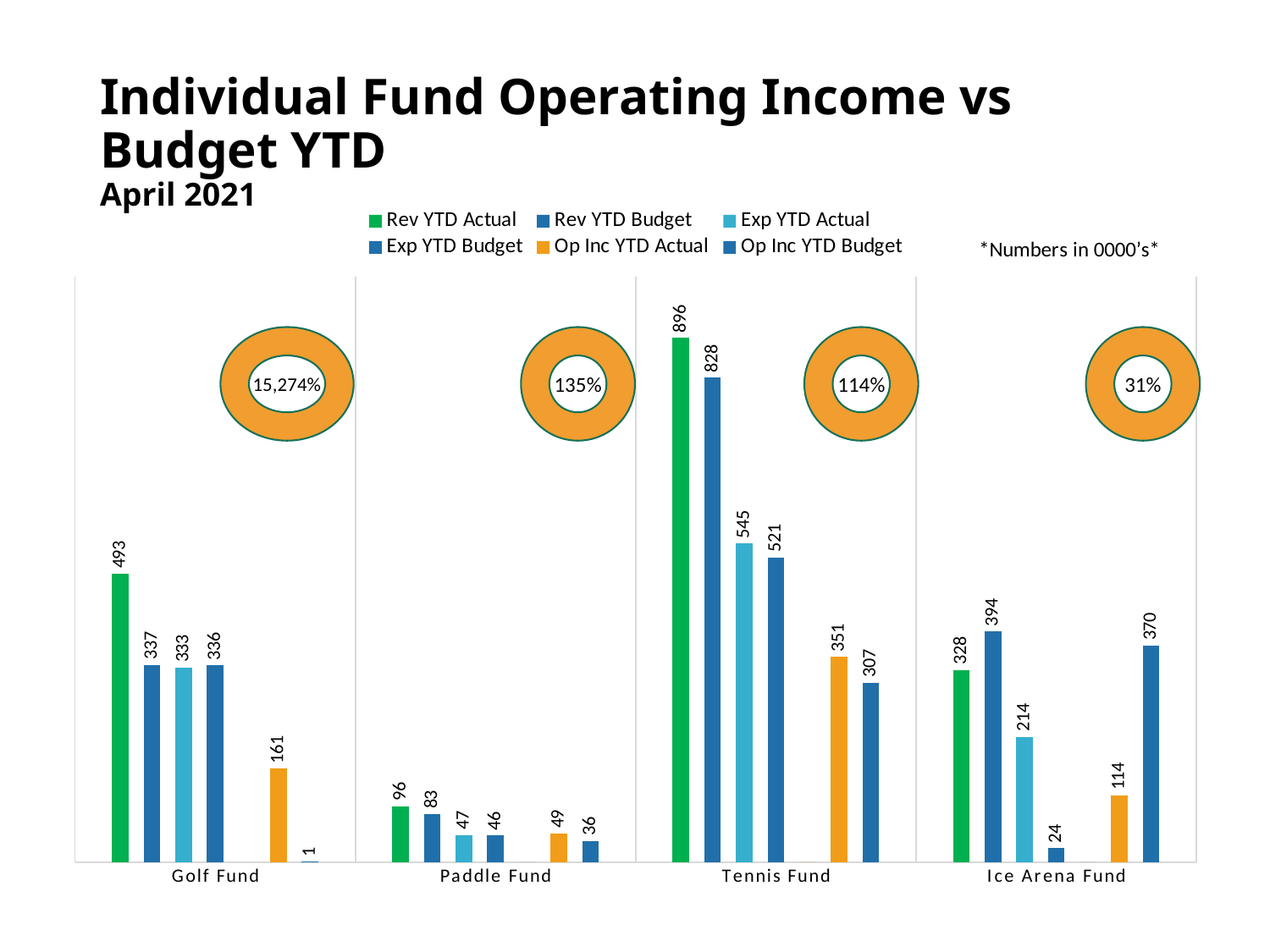
How many funds are shown on the x axis of the bar chart? 4 What kind of chart is used to show the fund values? Bar chart What percentage is shown in the donut above the Ice Arena Fund? 31% Which is larger for the Ice Arena Fund, Rev YTD Actual or Rev YTD Budget? Rev YTD Budget What is the Rev YTD Actual value for the Tennis Fund? 896 What is the Op Inc YTD Actual value for the Golf Fund? 161 Which fund has the highest Rev YTD Actual value? Tennis Fund How many series does the legend list? 6 What is the Op Inc YTD Budget value for the Paddle Fund? 36 What is the difference between Rev YTD Actual and Rev YTD Budget for the Golf Fund? 156 Which fund has the lowest Rev YTD Budget value? Paddle Fund What is the Exp YTD Actual value for the Ice Arena Fund? 214